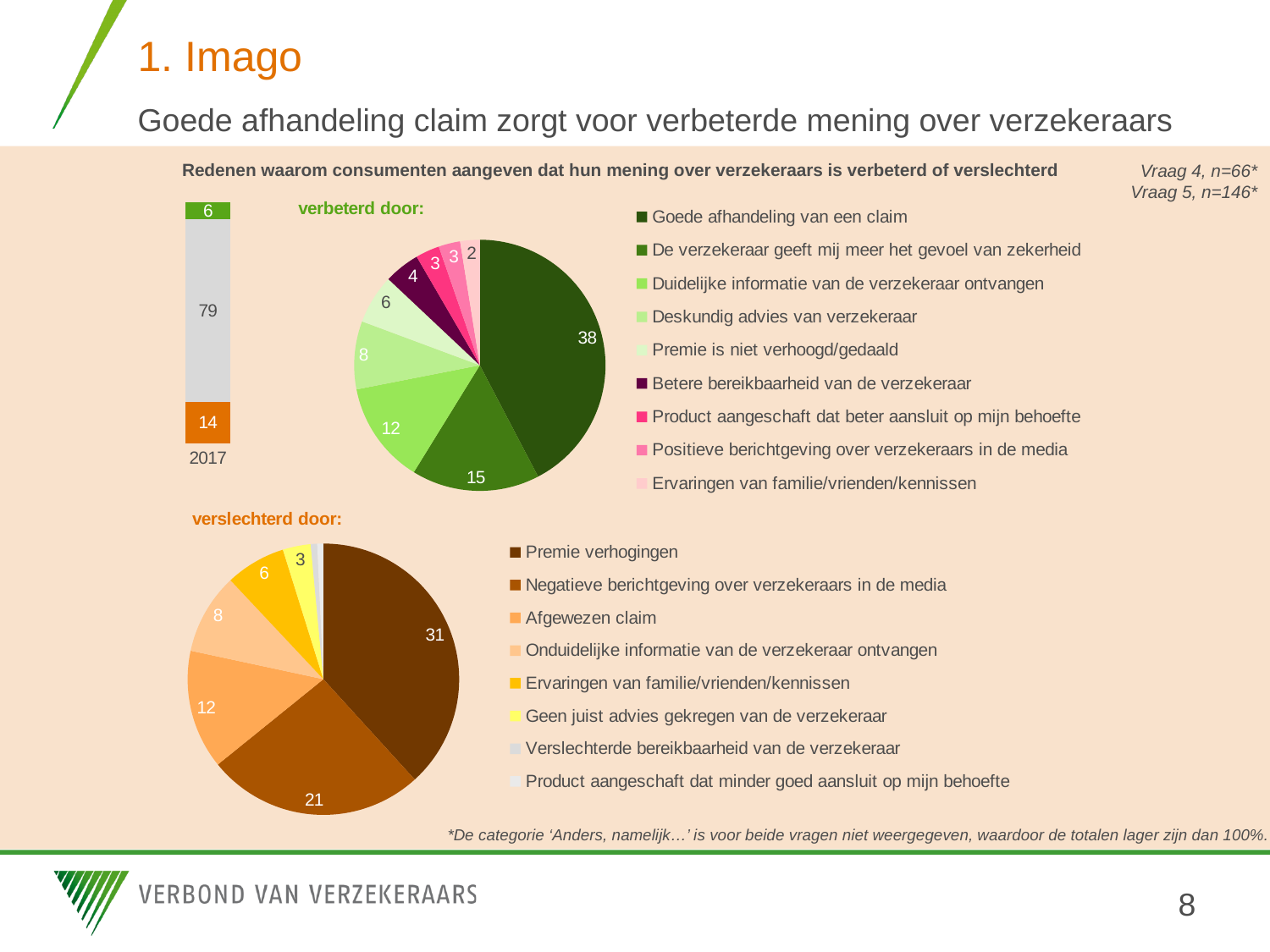
In the 'verbeterd door:' pie chart, what is the difference between 'Goede afhandeling van een claim' and 'De verzekeraar geeft mij meer het gevoel van zekerheid'? 23 In the 'verbeterd door:' pie chart, what is the value for 'Goede afhandeling van een claim'? 38 What is the total of the three segments in the stacked bar for 2017 on the left? 99 In the stacked bar chart for 2017 on the left, what is the value of the middle grey segment? 79 In the 'verbeterd door:' pie chart, what is the value for 'Duidelijke informatie van de verzekeraar ontvangen'? 12 In the 'verslechterd door:' pie chart, what is the difference between 'Premie verhogingen' and 'Afgewezen claim'? 19 In the 'verslechterd door:' pie chart, what is the value for 'Negatieve berichtgeving over verzekeraars in de media'? 21 How many categories does the legend of the 'verslechterd door:' pie chart list? 8 How many categories does the legend of the 'verbeterd door:' pie chart list? 9 In the 'verbeterd door:' pie chart, which category has the smallest slice? Ervaringen van familie/vrienden/kennissen In the 'verslechterd door:' pie chart, which category has the largest slice? Premie verhogingen In the 'verslechterd door:' pie chart, which is larger: 'Onduidelijke informatie van de verzekeraar ontvangen' or 'Ervaringen van familie/vrienden/kennissen'? Onduidelijke informatie van de verzekeraar ontvangen